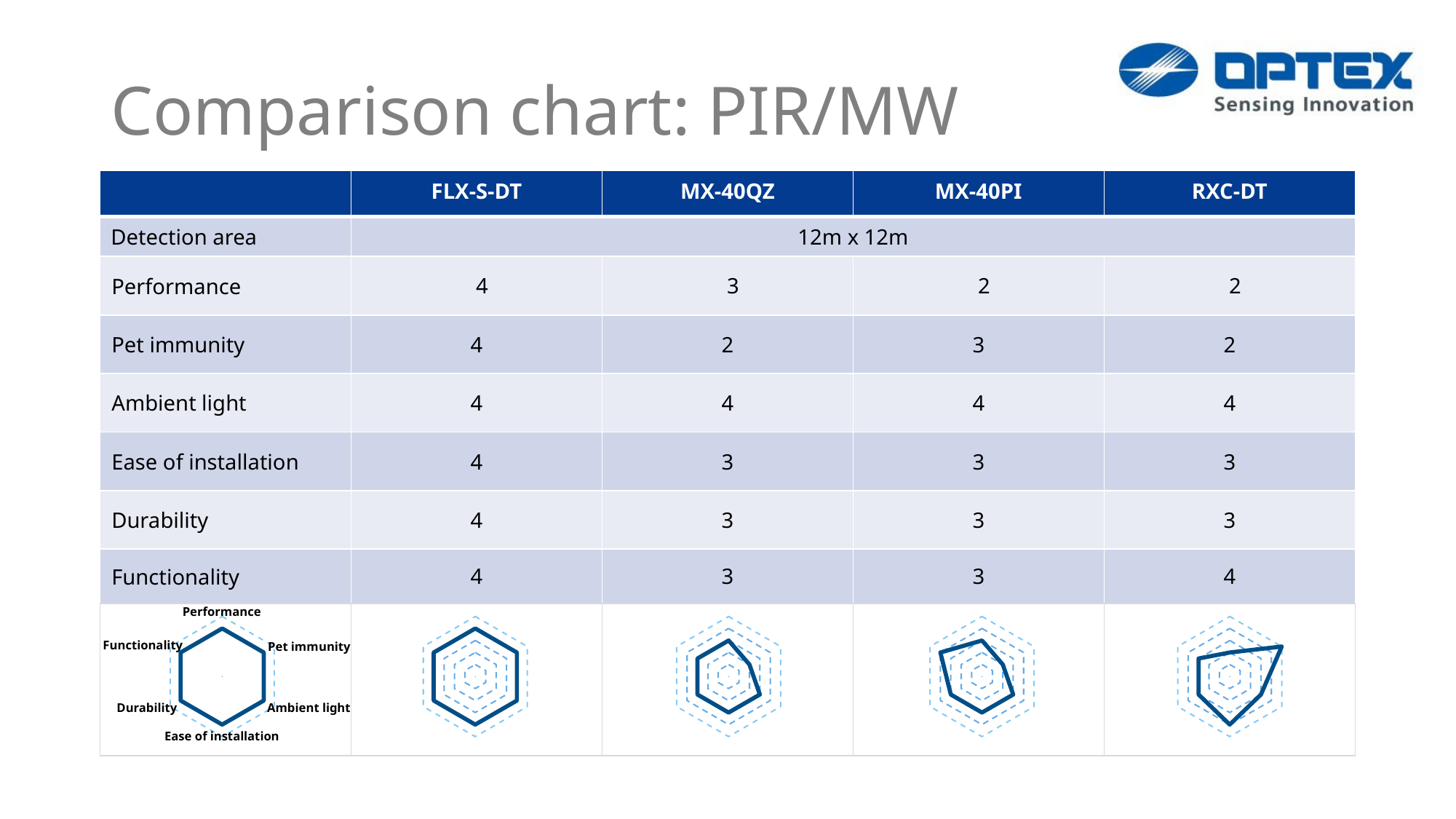
What kind of chart is shown beneath each product column in the bottom row of the table? Radar chart In the radar chart for RXC-DT, which category has the highest value? Pet immunity In the radar chart for MX-40QZ, what is the value for Pet immunity? 2 In the radar chart for FLX-S-DT, what is the value for Performance? 4 How many axes (categories) does each radar chart in the bottom row have? 6 Which axis label appears at the top of the radar chart key in the bottom-left cell? Performance